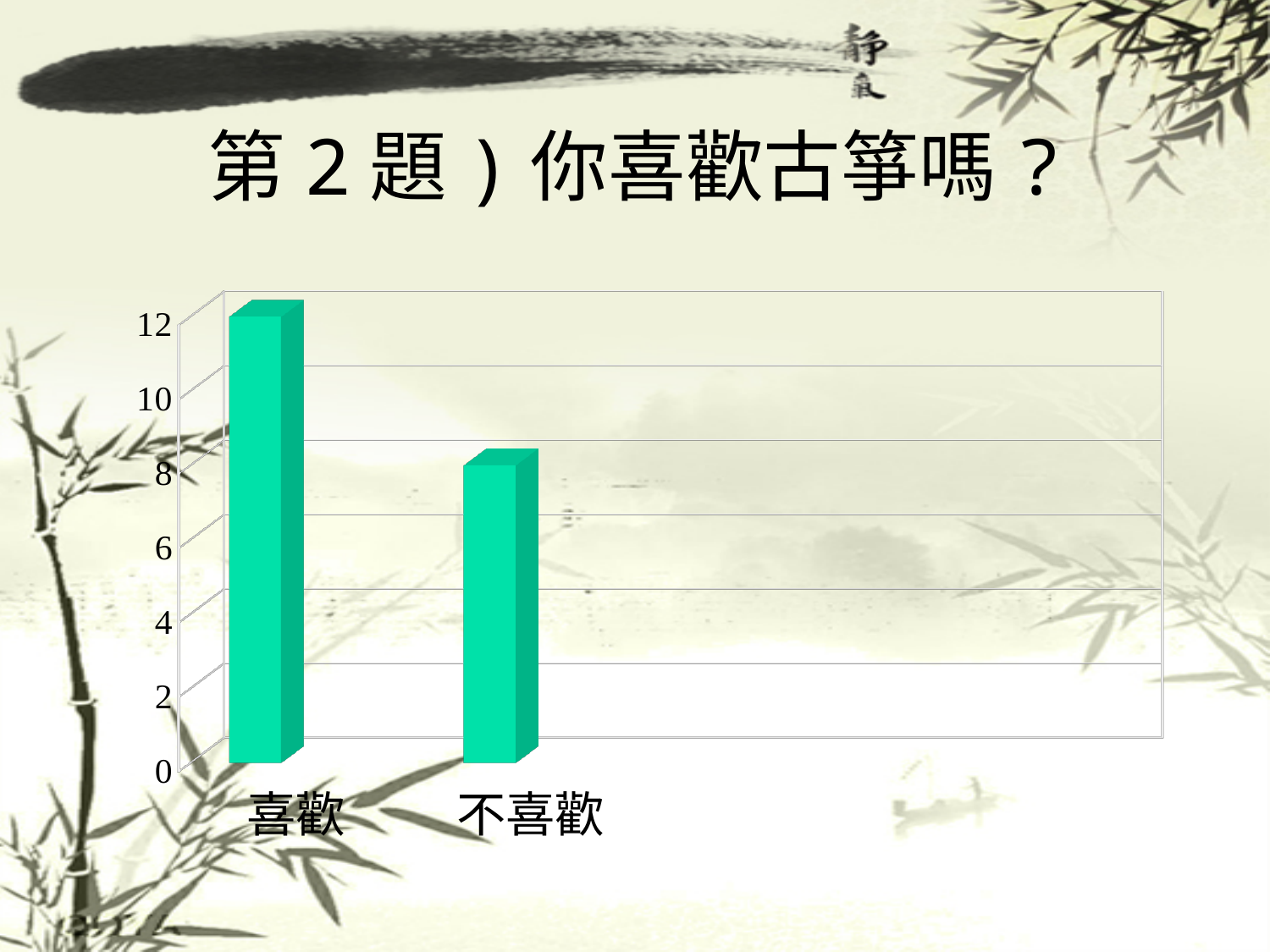
What is the title of the slide above the chart? 第 2 題）你喜歡古箏嗎？ Which category has the highest value? 喜歡 What is the value for 不喜歡? 8 Which category has the lowest value? 不喜歡 How many categories are shown in the chart? 2 What kind of chart is shown on the slide? bar chart What is the value for 喜歡? 12 What is the highest value shown on the vertical axis? 12 Is the value for 喜歡 greater or less than 10? greater Which is larger, the value for 喜歡 or the value for 不喜歡? 喜歡 Is the value for 不喜歡 greater or less than 10? less Is the value for 不喜歡 greater or less than 6? greater